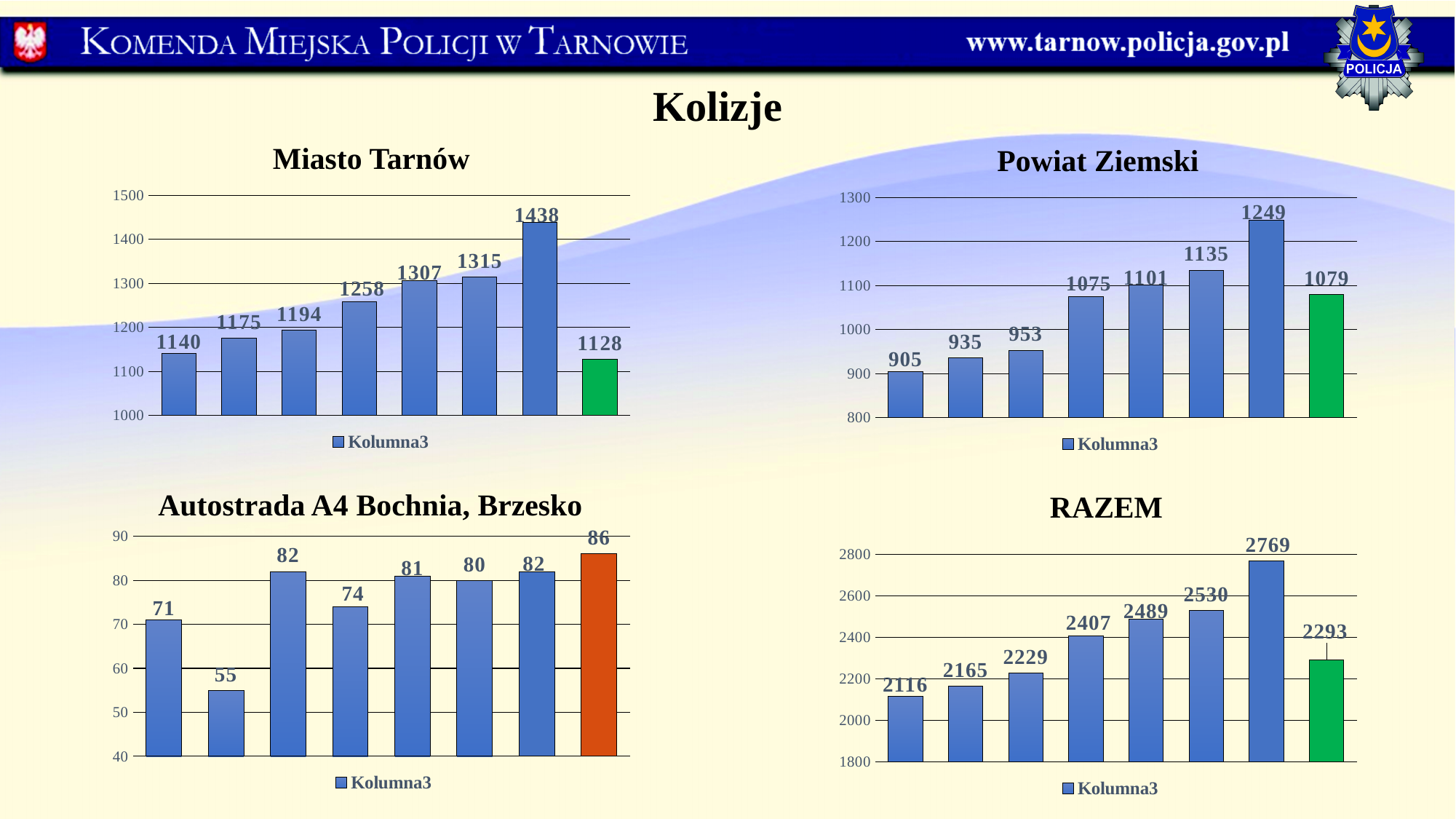
In the Autostrada A4 Bochnia, Brzesko chart, what is the lowest value shown? 55 In the Powiat Ziemski chart, what is the difference between the highest bar and the green bar? 170 What kind of chart is the Miasto Tarnów chart? bar chart In the Miasto Tarnów chart, which is larger: the first bar or the last (green) bar? the first bar How many bars are plotted in the RAZEM chart? 8 In the Miasto Tarnów chart, what is the highest value shown? 1438 In the RAZEM chart, what is the difference between the last (green) bar and the first bar? 177 In the RAZEM chart, what is the highest value shown? 2769 In the Powiat Ziemski chart, what is the lowest value shown? 905 In the Miasto Tarnów chart, what is the value of the green bar? 1128 In the Autostrada A4 Bochnia, Brzesko chart, what is the value of the orange bar? 86 In the Powiat Ziemski chart, do the values rise or fall across the first seven bars? rise